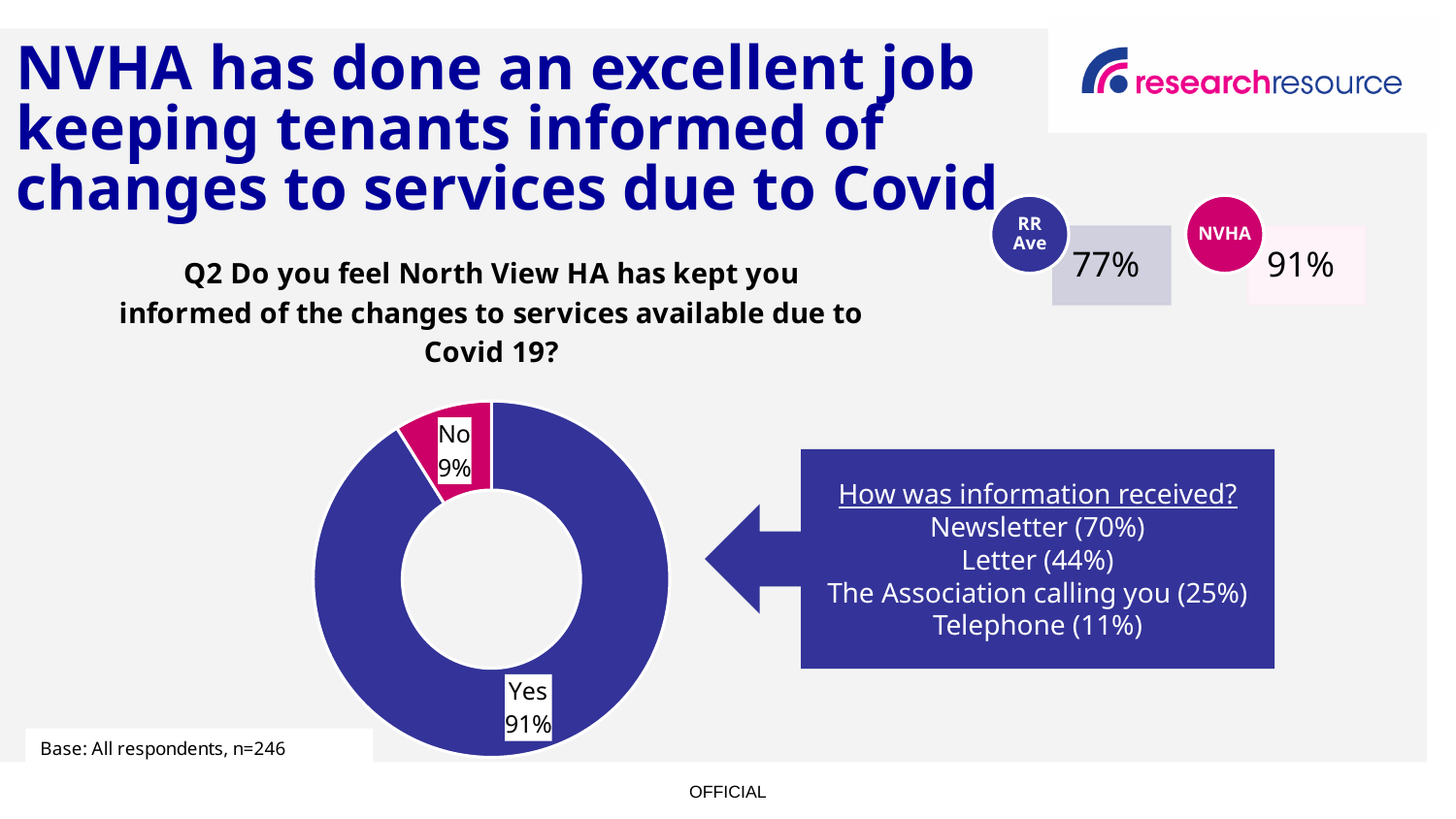
What percentage of respondents answered Yes in the doughnut chart? 91% What is the RR Ave value shown on the slide? 77% What colour is the No segment in the doughnut chart? Pink/magenta Which response has the smallest share in the doughnut chart? No Which response has the largest share in the doughnut chart? Yes What type of chart is used to show the Q2 responses? Doughnut chart What is the NVHA value shown on the slide next to the RR Ave? 91% What percentage of respondents answered No in the doughnut chart? 9% Which is larger in the doughnut chart, the Yes share or the No share? Yes How many categories are shown in the doughnut chart? 2 What is the base (number of respondents) for the chart? n=246 What is the difference in percentage points between the Yes and No shares in the doughnut chart? 82